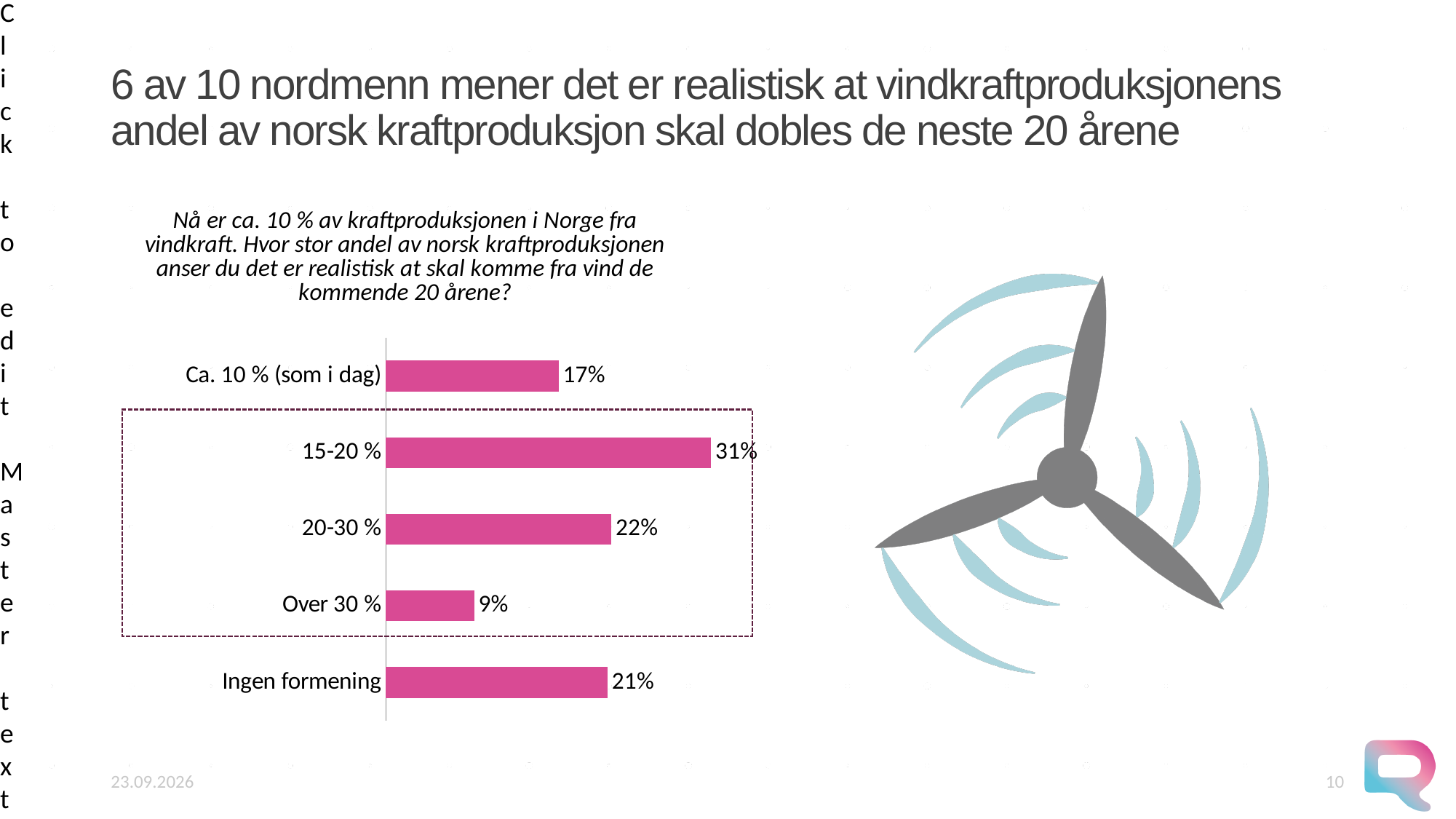
What is the value for "Ingen formening"? 21% Which category has the highest value? 15-20 % What is the value for "15-20 %"? 31% What is the value for "Over 30 %"? 9% What is the value for "Ca. 10 % (som i dag)"? 17% What kind of chart is shown on the slide? Bar chart Which category has the lowest value? Over 30 % What is the difference between the values for "15-20 %" and "20-30 %"? 9% How many categories are shown in the chart? 5 Which is larger, the value for "20-30 %" or the value for "Ingen formening"? 20-30 % What is the combined value of the three categories inside the dashed box (15-20 %, 20-30 %, Over 30 %)? 62% What colour are the bars in the chart? Pink